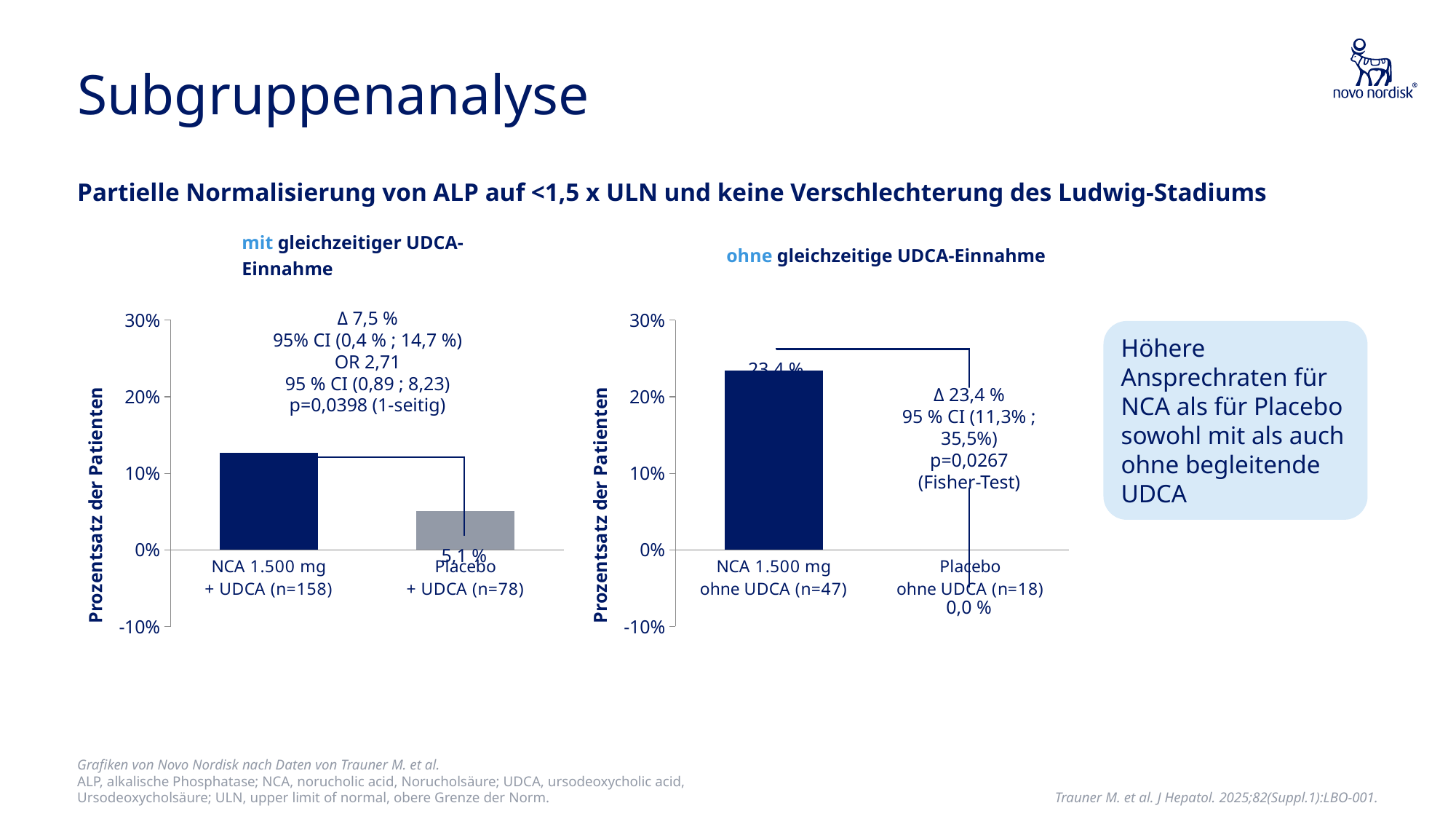
In the chart 'mit gleichzeitiger UDCA-Einnahme', what difference (Δ) between the two groups is printed on the chart? 7,5 % What is the y-axis label of the chart 'mit gleichzeitiger UDCA-Einnahme'? Prozentsatz der Patienten What type of chart is the chart 'ohne gleichzeitige UDCA-Einnahme'? bar chart In the chart 'mit gleichzeitiger UDCA-Einnahme', what is the value for Placebo + UDCA (n=78)? 5,1 % In the chart 'ohne gleichzeitige UDCA-Einnahme', is the value for NCA 1.500 mg ohne UDCA greater or less than 20%? greater In the chart 'ohne gleichzeitige UDCA-Einnahme', which group has the highest value? NCA 1.500 mg ohne UDCA (n=47) How many bars are shown in the chart 'mit gleichzeitiger UDCA-Einnahme'? 2 In the chart 'ohne gleichzeitige UDCA-Einnahme', what is the value for NCA 1.500 mg ohne UDCA (n=47)? 23,4 % In the chart 'mit gleichzeitiger UDCA-Einnahme', which bar is higher: NCA 1.500 mg + UDCA or Placebo + UDCA? NCA 1.500 mg + UDCA In the chart 'ohne gleichzeitige UDCA-Einnahme', what is the value for Placebo ohne UDCA (n=18)? 0,0 % In the chart 'ohne gleichzeitige UDCA-Einnahme', what is the difference between the NCA 1.500 mg and Placebo values? 23,4 % In the chart 'mit gleichzeitiger UDCA-Einnahme', is the value for NCA 1.500 mg + UDCA (n=158) greater or less than 10%? greater